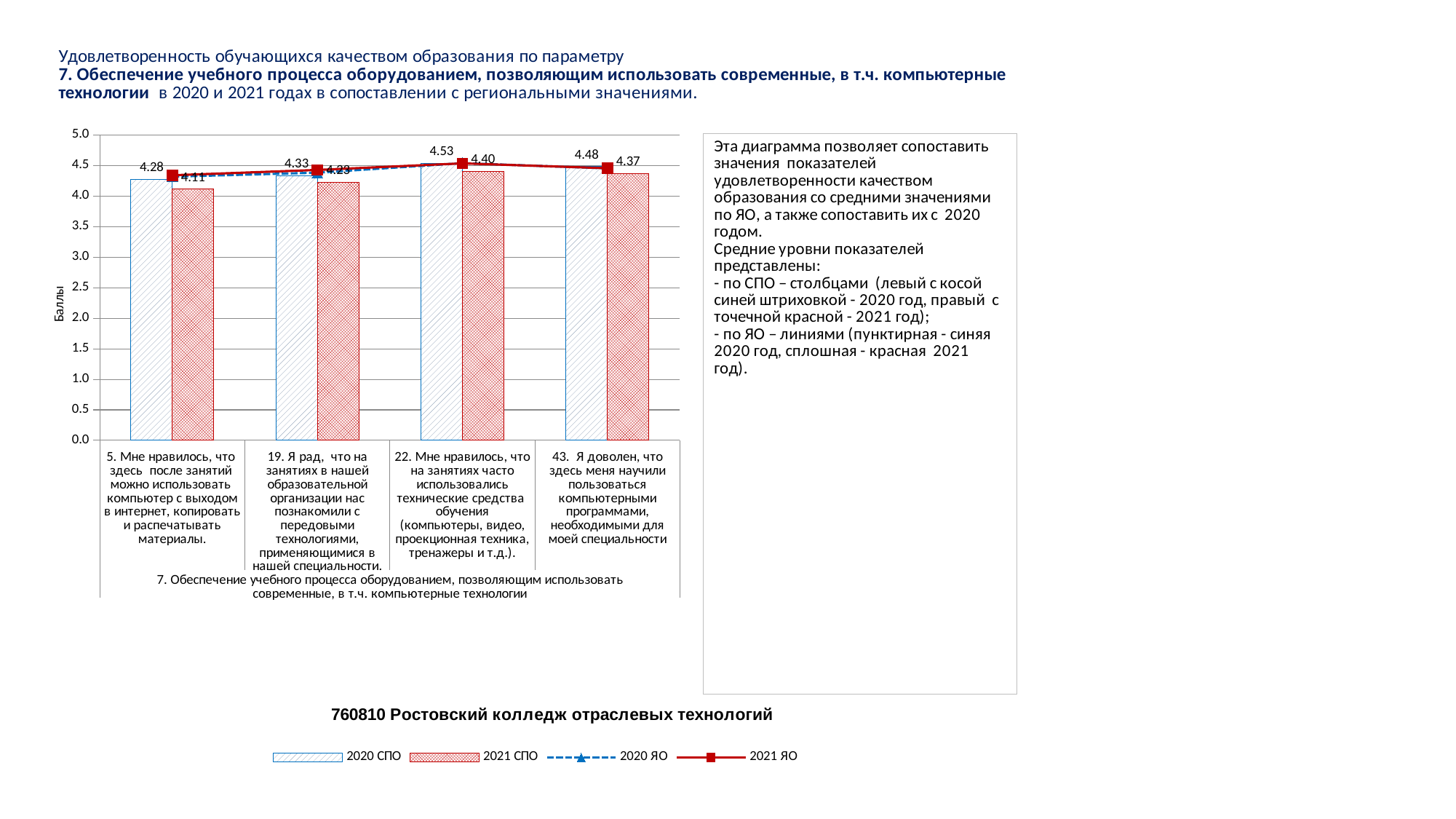
For question 22, which is larger: the 2020 СПО value or the 2021 СПО value? 2020 СПО What is the 2020 СПО value for question 5 ("Мне нравилось, что здесь после занятий можно использовать компьютер...")? 4.28 What is the 2021 СПО value for question 22 ("Мне нравилось, что на занятиях часто использовались технические средства обучения...")? 4.40 How many series does the legend list? 4 What is the difference between the 2020 СПО and 2021 СПО values for question 19? 0.10 Is the 2021 СПО value for question 5 greater or less than 4.5? less What type of chart is used to show the СПО values? Bar chart What is the 2021 СПО value for question 43 ("Я доволен, что здесь меня научили пользоваться компьютерными программами...")? 4.37 What is the label of the vertical axis? Баллы Which question has the lowest 2021 СПО value? 5. Мне нравилось, что здесь после занятий можно использовать компьютер с выходом в интернет Which question has the highest 2020 СПО value? 22. Мне нравилось, что на занятиях часто использовались технические средства обучения How many question categories are shown on the x axis? 4